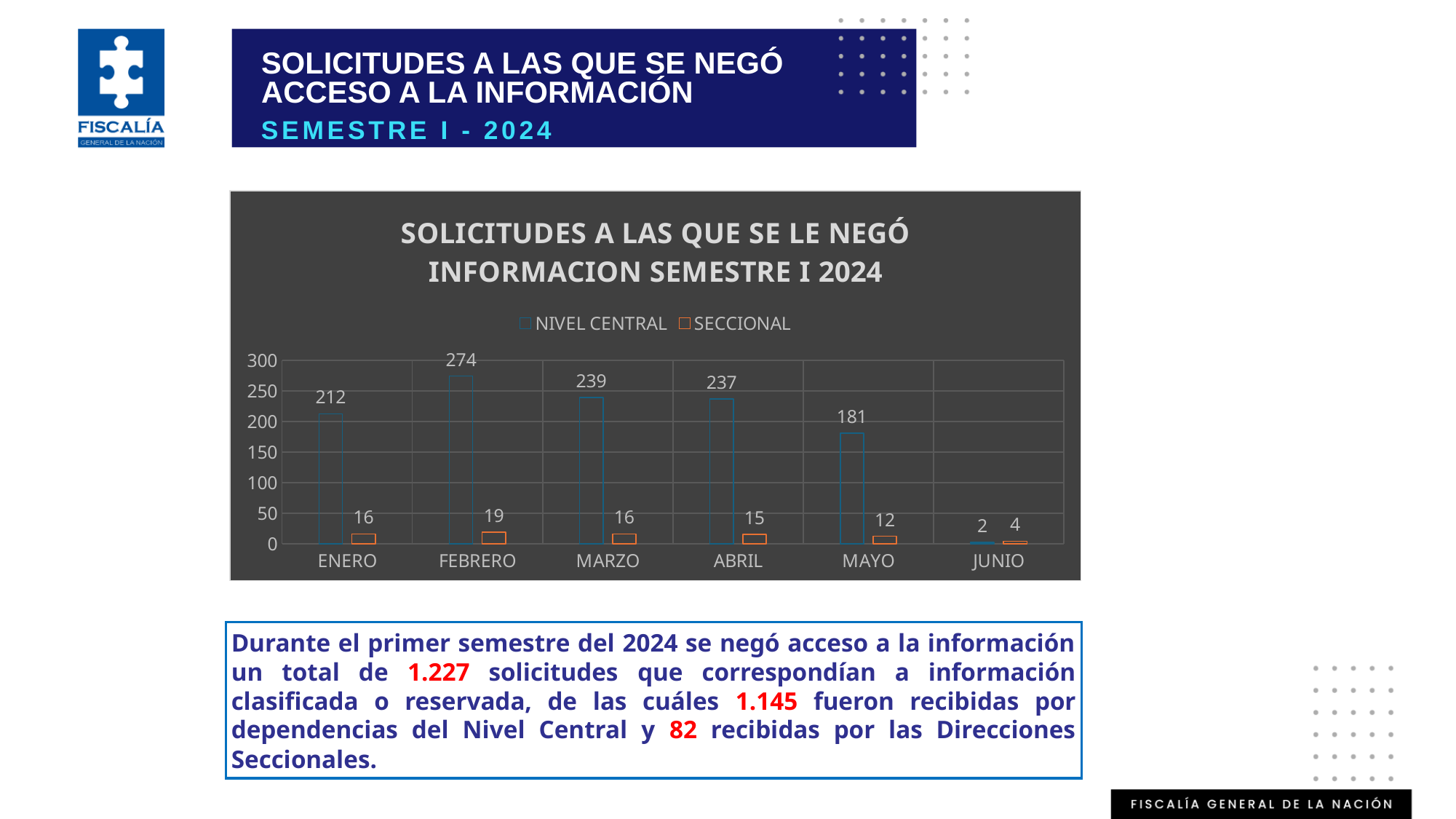
Which is larger, the SECCIONAL value for ENERO or for FEBRERO? FEBRERO What kind of chart is shown? bar chart How many series does the legend list? 2 Which month has the highest NIVEL CENTRAL value? FEBRERO What is the NIVEL CENTRAL value for FEBRERO? 274 What is the NIVEL CENTRAL value for JUNIO? 2 Is the NIVEL CENTRAL value for MAYO greater or less than 200? less What is the difference between the NIVEL CENTRAL values for MARZO and ABRIL? 2 What is the SECCIONAL value for MAYO? 12 Which month has the lowest SECCIONAL value? JUNIO What is the total of the NIVEL CENTRAL and SECCIONAL values for ENERO? 228 How many months are shown on the x axis? 6